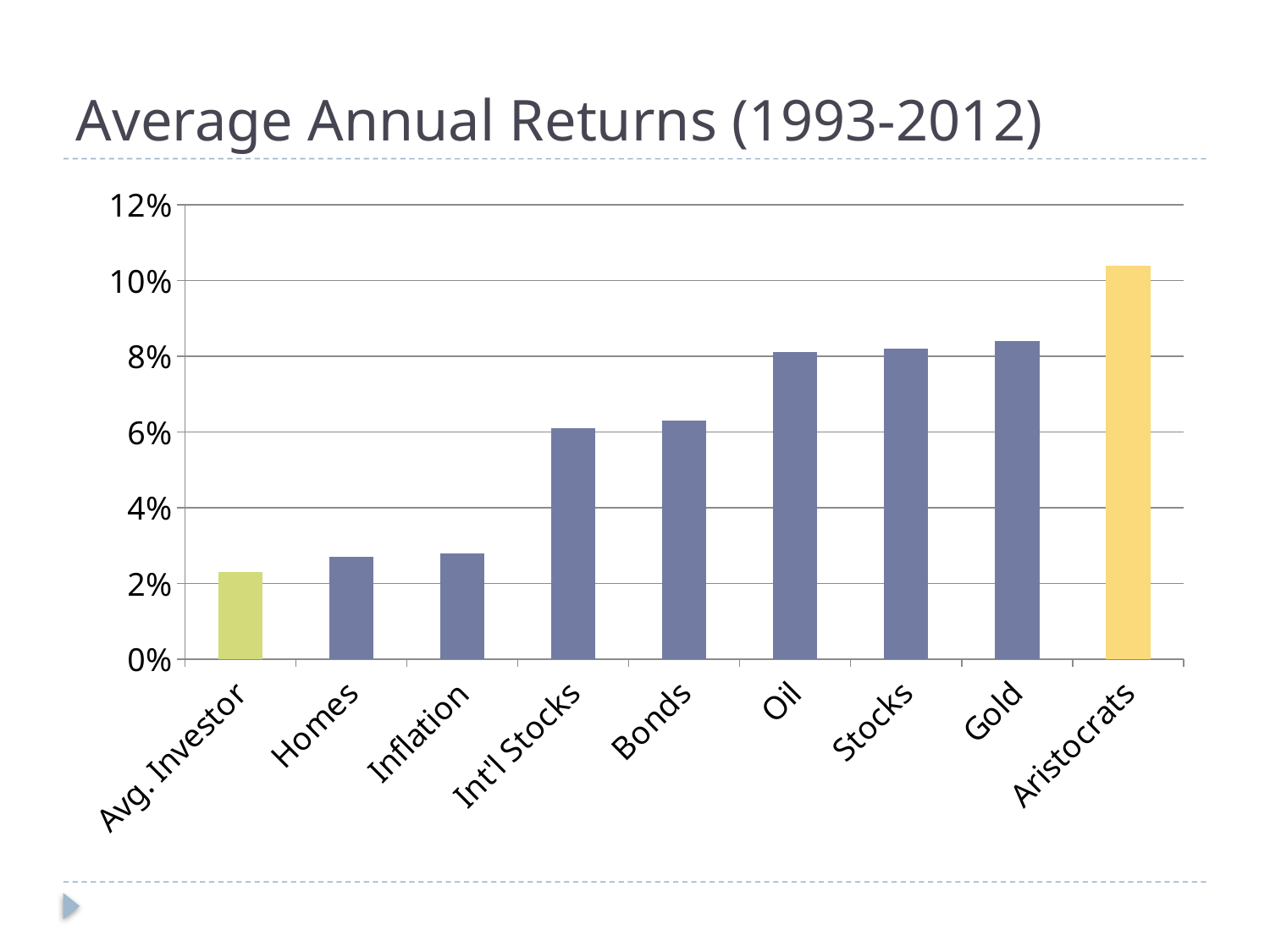
What kind of chart is shown on the slide? Bar chart Is the value for Aristocrats greater or less than 10%? greater Is the value for Gold greater or less than 8%? greater Which is larger, the value for Bonds or the value for Homes? Bonds Do the values generally rise or fall moving from left to right along the x axis? Rise Which category has the highest average annual return? Aristocrats How many categories are shown on the x axis? 9 What is the title of the chart? Average Annual Returns (1993-2012) Is the value for Stocks greater or less than 10%? less Which is larger, the value for Aristocrats or the value for Gold? Aristocrats Which category has the lowest average annual return? Avg. Investor